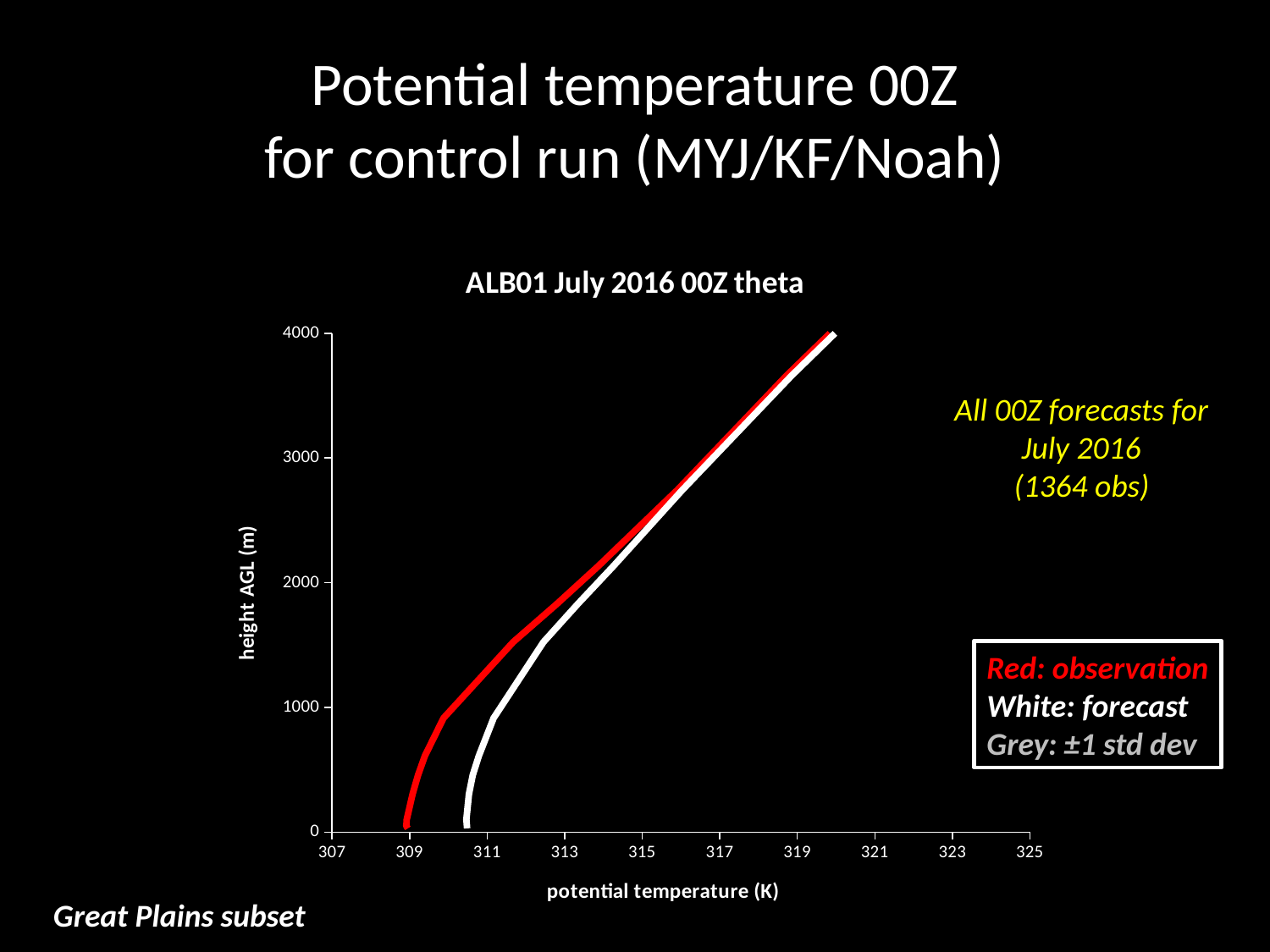
At a height of 1000 m, which line shows the larger potential temperature, the red observation or the white forecast? white forecast At a height of 2000 m, is the potential temperature of the white forecast line greater or less than 311 K? greater How many entries does the legend box on the slide list? 3 What is the label of the x axis of the chart? potential temperature (K) Does potential temperature rise or fall as height AGL increases? rise At a height of 4000 m, is the potential temperature of the red observation line greater or less than 317 K? greater At a height of 0 m, is the potential temperature of the white forecast line greater or less than 309 K? greater What kind of chart is shown on the slide? line chart How many lines are plotted on the chart? 2 What is the title of the chart? ALB01 July 2016 00Z theta At a height of 0 m, which line shows the lower potential temperature, the red observation or the white forecast? red observation